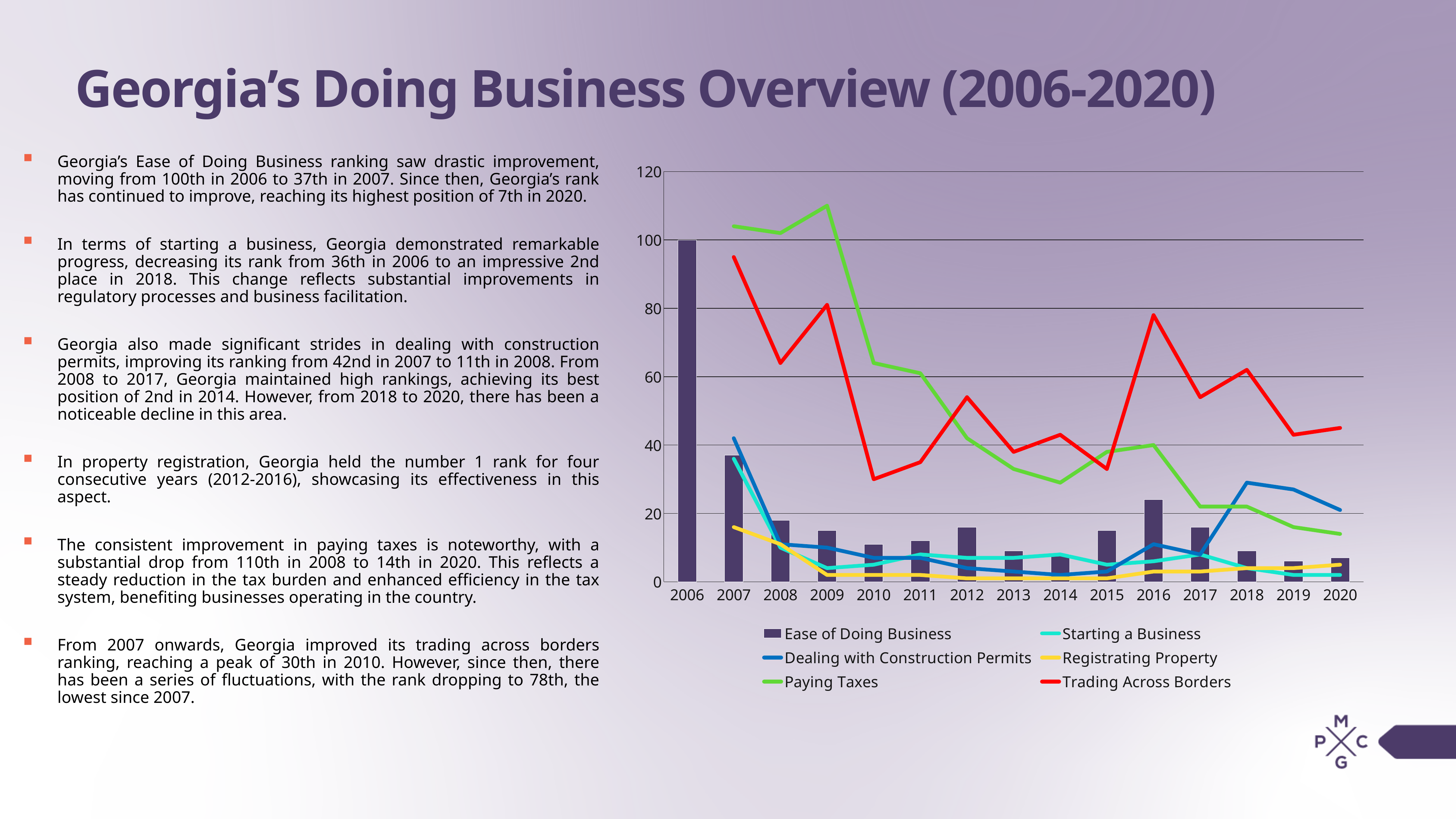
Is the Trading Across Borders value for 2010 greater or less than 40? less In which year is the Ease of Doing Business bar the highest? 2006 What kind of chart is shown on the slide? A combined bar and line chart What is the Ease of Doing Business value for 2006? 100 How many years are shown along the x axis of the chart? 15 How many series does the chart legend list? 6 Is the Paying Taxes value for 2009 greater or less than 100? greater In 2016, which is higher: Trading Across Borders or Paying Taxes? Trading Across Borders Is the Trading Across Borders value for 2007 greater or less than 80? greater Does the Paying Taxes line generally rise or fall from 2009 to 2020? fall Which series is drawn as bars rather than a line? Ease of Doing Business